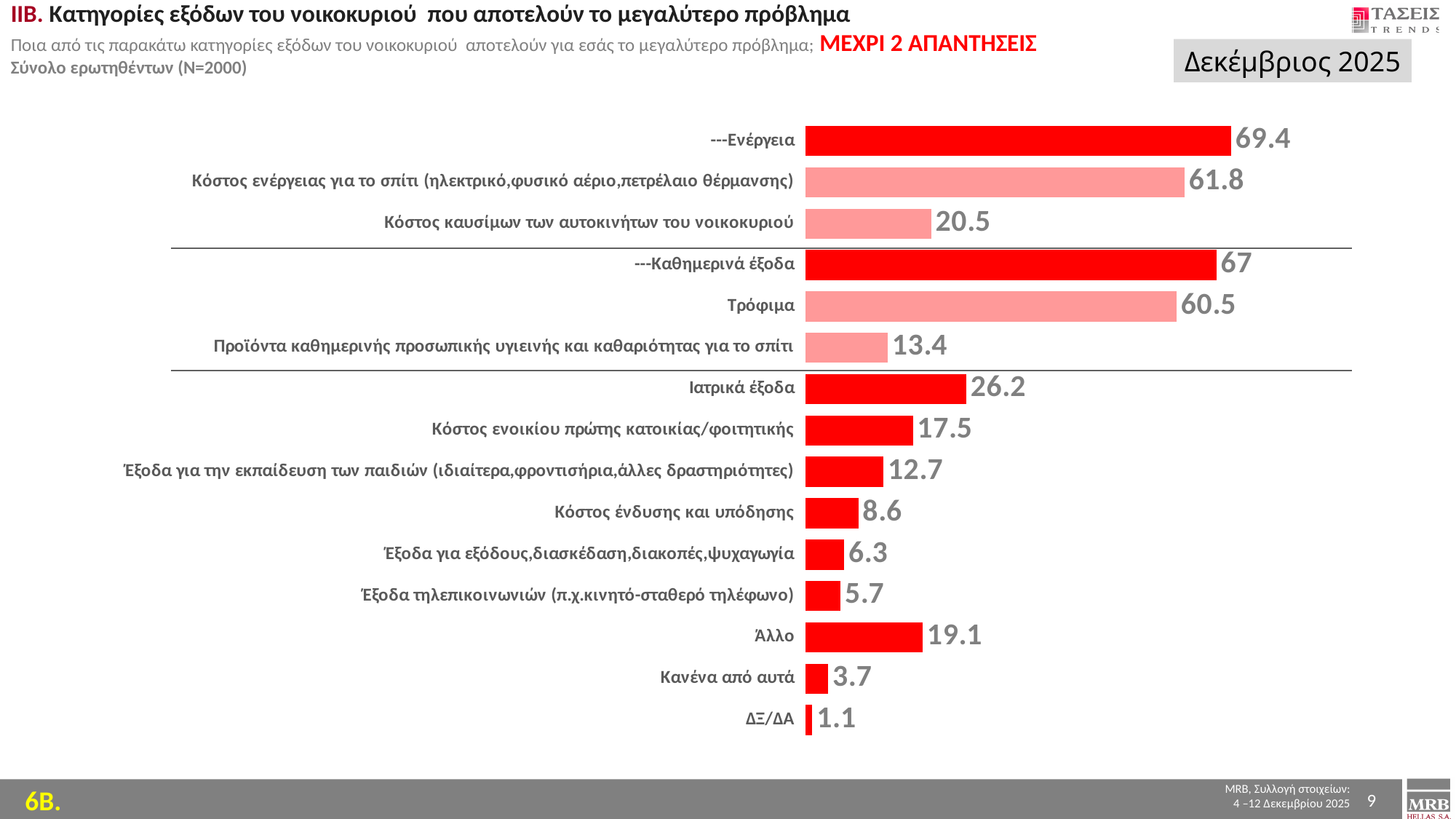
Which category has the highest value? ---Ενέργεια What value is shown for Κόστος ενοικίου πρώτης κατοικίας/φοιτητικής? 17.5 What is the difference between the values for ---Ενέργεια and ---Καθημερινά έξοδα? 2.4 What sample size (N) is stated on the slide? N=2000 How many bars are plotted in the chart? 15 What value is shown for Τρόφιμα? 60.5 What is the difference between the values for Κόστος καυσίμων των αυτοκινήτων του νοικοκυριού and Προϊόντα καθημερινής προσωπικής υγιεινής και καθαριότητας για το σπίτι? 7.1 Which is larger: the value for Άλλο or the value for Κόστος ενοικίου πρώτης κατοικίας/φοιτητικής? Άλλο What value is shown for Κανένα από αυτά? 3.7 Which category has the lowest value? ΔΞ/ΔΑ What value is shown for Ιατρικά έξοδα? 26.2 What type of chart is shown on the slide? Bar chart